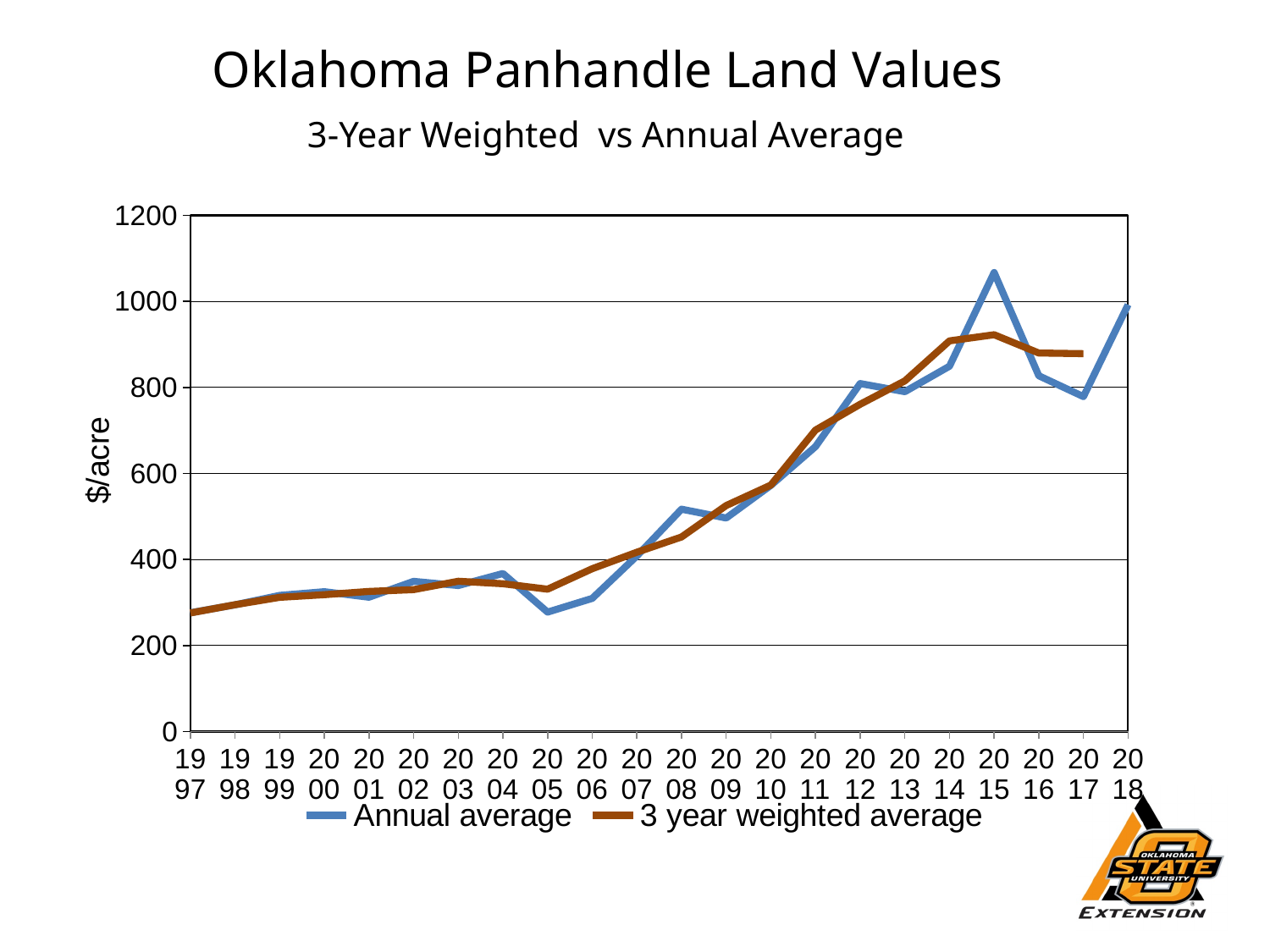
Overall, do the land values rise or fall from 1997 to 2018? rise What is the label on the y axis? $/acre In which year does the Annual average series reach its highest value? 2015 In 2017, which series has the larger value, Annual average or 3 year weighted average? 3 year weighted average In 2015, which series has the larger value, Annual average or 3 year weighted average? Annual average How many years are plotted along the x axis? 22 Is the Annual average value for 1997 greater or less than 400? less Is the Annual average value for 2005 greater or less than 400? less Is the 3 year weighted average value for 2017 greater or less than 800? greater What kind of chart is shown on the slide? line chart How many series does the legend list? 2